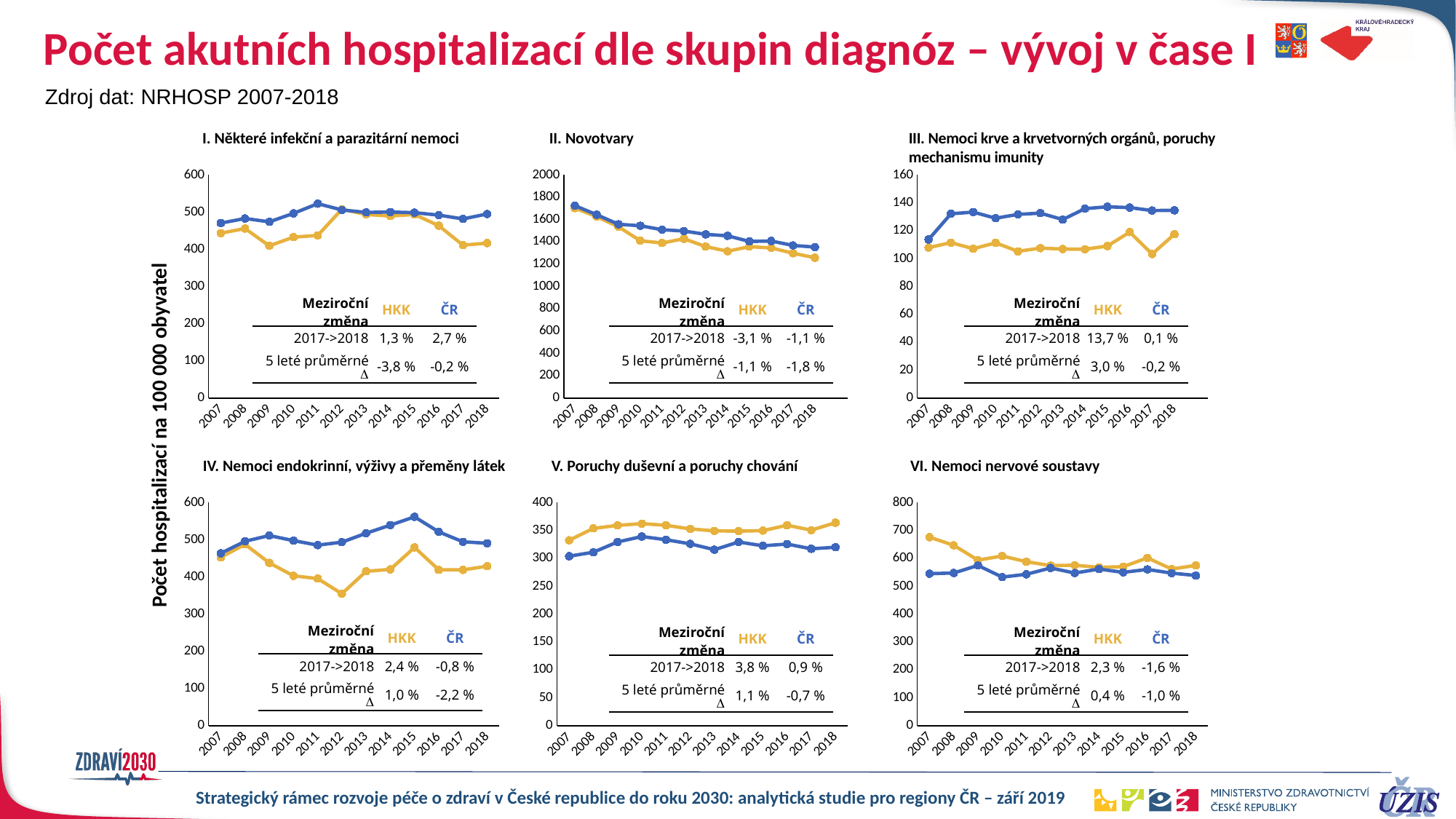
How many series are shown in the chart "IV. Nemoci endokrinní, výživy a přeměny látek"? 2 In the chart "IV. Nemoci endokrinní, výživy a přeměny látek", what is the 5 leté průměrné Δ for ČR? -2,2 % In the chart "V. Poruchy duševní a poruchy chování", which is larger, the 2017->2018 change for HKK or for ČR? HKK In the chart "III. Nemoci krve a krvetvorných orgánů, poruchy mechanismu imunity", what is the 2017->2018 change for HKK? 13,7 % In the chart "II. Novotvary", do the values generally rise or fall from 2007 to 2018? fall How many years are plotted on the x axis of the chart "I. Některé infekční a parazitární nemoci"? 12 In the chart "II. Novotvary", what is the 2017->2018 change for ČR? -1,1 % In the chart "I. Některé infekční a parazitární nemoci", what is the 2017->2018 change for HKK? 1,3 % In the chart "VI. Nemoci nervové soustavy", is the HKK value for 2007 greater or less than 600? greater In the chart "VI. Nemoci nervové soustavy", what is the 5 leté průměrné Δ for HKK? 0,4 % What kind of chart is used for "II. Novotvary"? line chart In the chart "II. Novotvary", is the ČR value for 2007 greater or less than 1600? greater